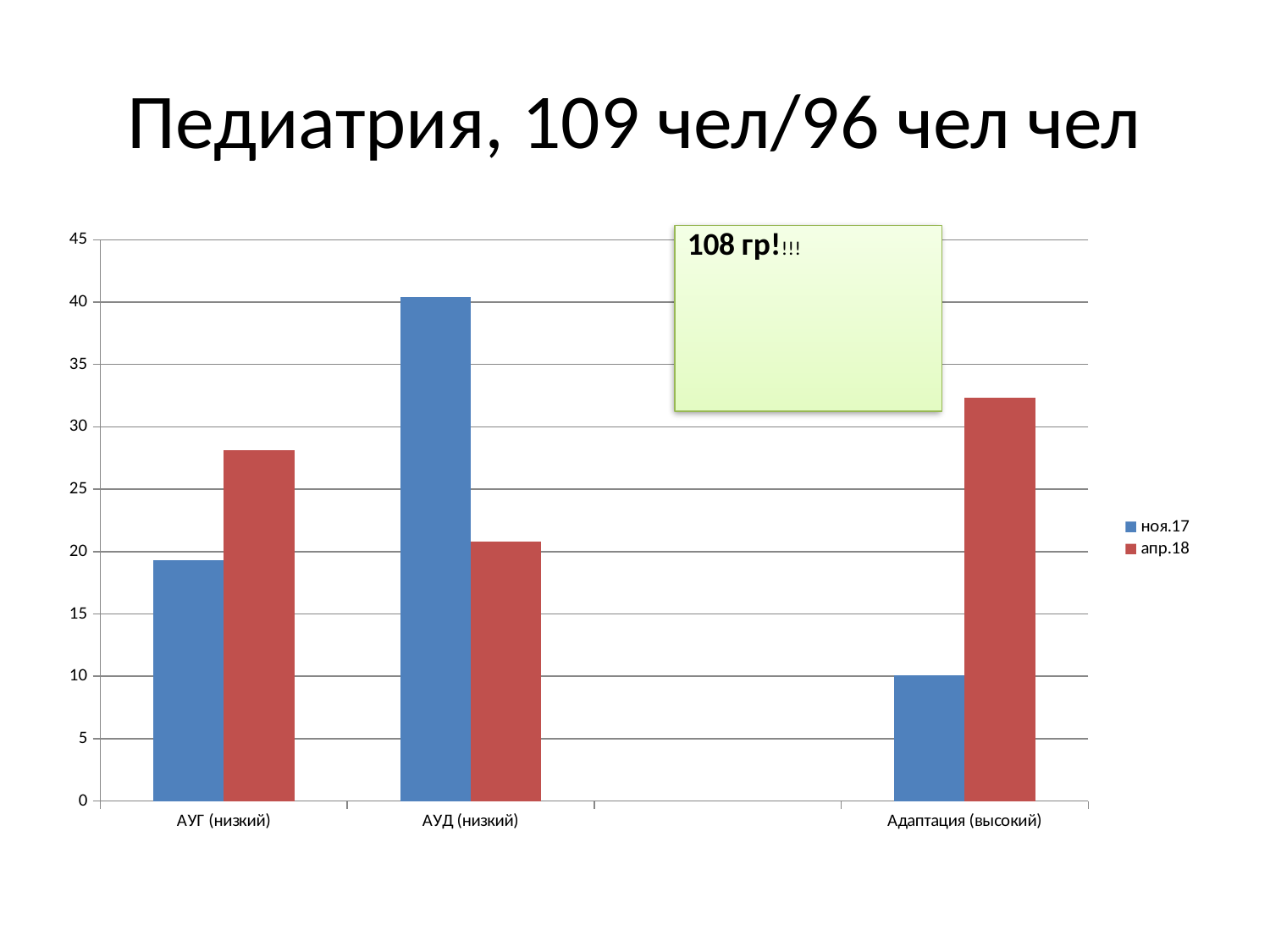
Which category has the lowest value for the апр.18 series? АУД (низкий) For АУД (низкий), which series has the larger value, ноя.17 or апр.18? ноя.17 For Адаптация (высокий), which series has the larger value, ноя.17 or апр.18? апр.18 How many series does the legend list? 2 What are the two series named in the legend? ноя.17 and апр.18 What kind of chart is shown on the slide? bar chart What is the title of the slide above the chart? Педиатрия, 109 чел/96 чел чел Is the апр.18 value for АУГ (низкий) greater or less than 25? greater Which category has the highest value for the ноя.17 series? АУД (низкий) Which category has the lowest value for the ноя.17 series? Адаптация (высокий) Which category has the highest value for the апр.18 series? Адаптация (высокий)